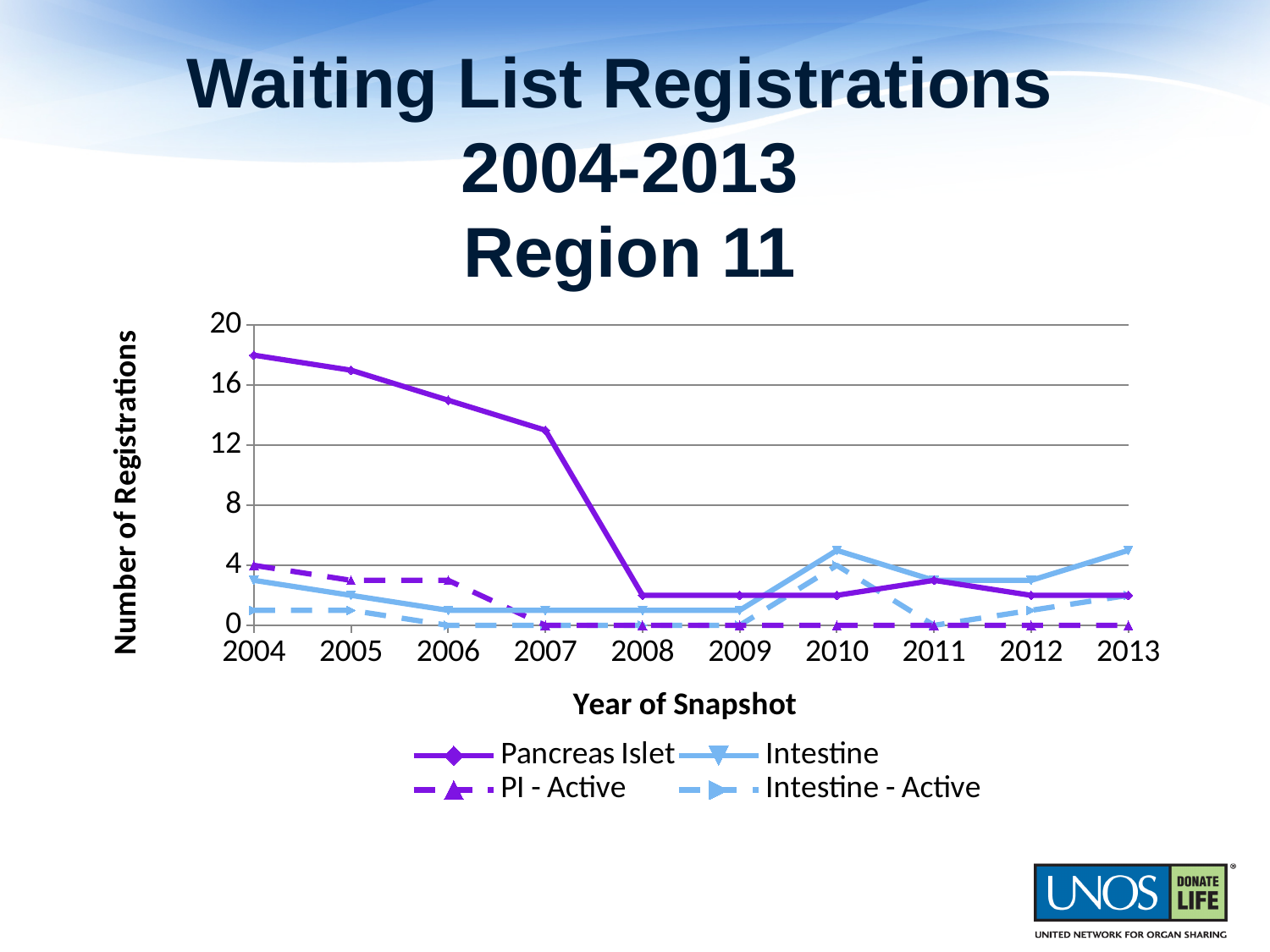
Which is larger in 2004, Pancreas Islet or Intestine? Pancreas Islet How many years are plotted along the x axis? 10 How many series does the legend list? 4 Is the value for Pancreas Islet in 2004 greater or less than 16? greater What is the value for PI - Active in 2004? 4 What is the value for PI - Active in 2010? 0 Is the value for Pancreas Islet in 2007 greater or less than 12? greater What kind of chart is shown on the slide? line chart In which year is the Pancreas Islet series at its highest? 2004 What is the title of the x axis? Year of Snapshot Is the value for Pancreas Islet in 2008 greater or less than 4? less Does the Pancreas Islet series rise or fall from 2004 to 2008? fall